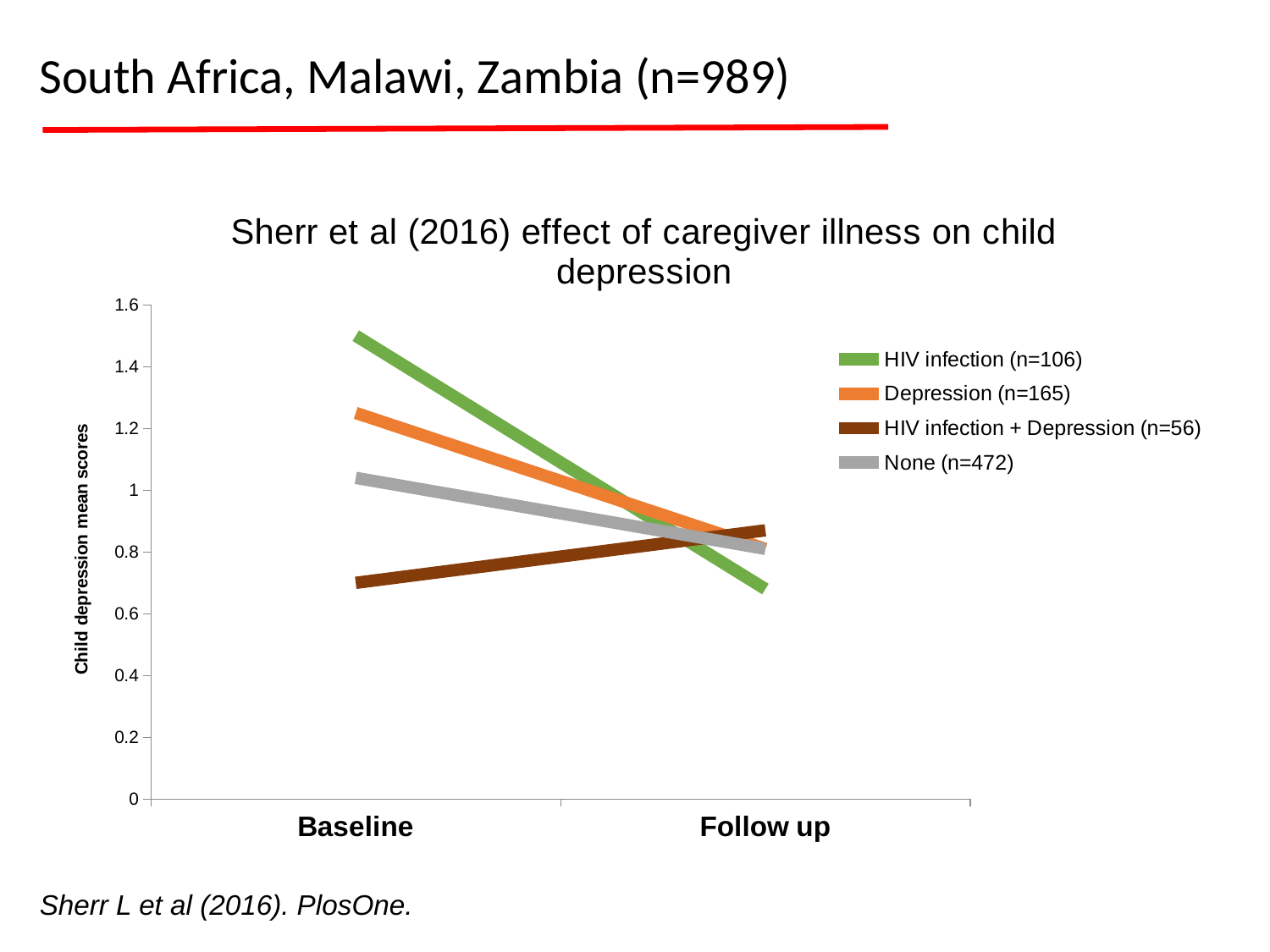
Is the Baseline value for HIV infection + Depression (n=56) greater or less than 0.8? less How many time points are shown on the x axis? 2 What kind of chart is shown on the slide? line chart How many series does the legend list? 4 At Baseline, which is larger: the value for HIV infection (n=106) or the value for None (n=472)? HIV infection (n=106) What is the title of the chart? Sherr et al (2016) effect of caregiver illness on child depression Does the child depression mean score for HIV infection + Depression (n=56) rise or fall from Baseline to Follow up? rise Which series has the lowest child depression mean score at Baseline? HIV infection + Depression (n=56) Is the Baseline value for HIV infection (n=106) greater or less than 1.4? greater Which series has the highest child depression mean score at Baseline? HIV infection (n=106) Is the Follow up value for HIV infection (n=106) greater or less than 0.8? less Does the child depression mean score for HIV infection (n=106) rise or fall from Baseline to Follow up? fall